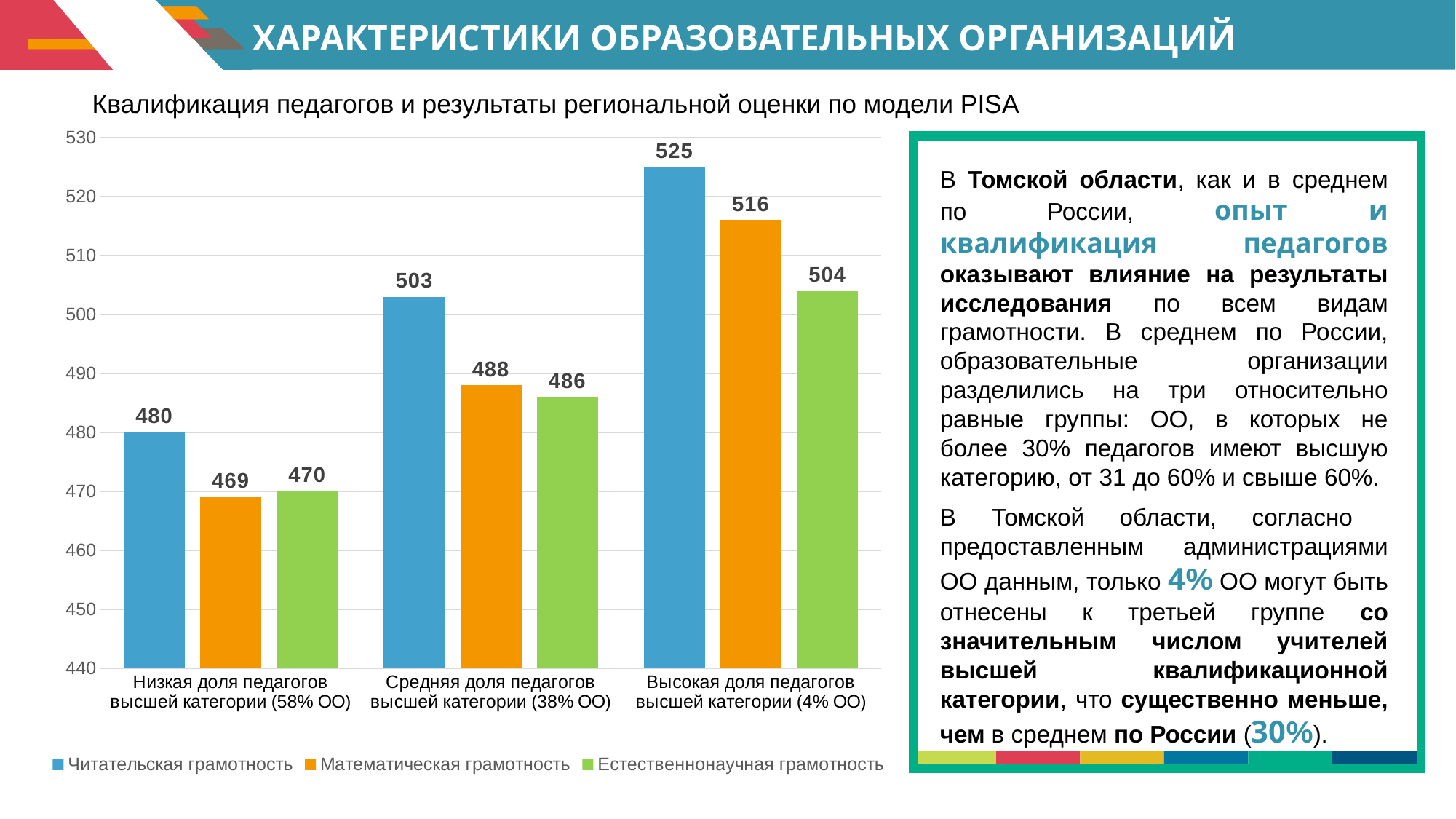
Is the value for Естественнонаучная грамотность in the Высокая доля (4% ОО) category greater or less than 500? greater Which is larger in the Средняя доля педагогов высшей категории (38% ОО) category: Математическая грамотность or Естественнонаучная грамотность? Математическая грамотность What is the value for Математическая грамотность in the category Высокая доля педагогов высшей категории (4% ОО)? 516 How many categories are shown on the x axis? 3 Which category has the highest value for Читательская грамотность? Высокая доля педагогов высшей категории (4% ОО) How many series does the legend list? 3 What is the difference between Читательская грамотность in the Высокая доля (4% ОО) category and in the Низкая доля (58% ОО) category? 45 Do the values for Читательская грамотность rise or fall from left to right across the categories? rise What kind of chart is shown on the slide? bar chart Which category has the lowest value for Математическая грамотность? Низкая доля педагогов высшей категории (58% ОО) What is the value for Естественнонаучная грамотность in the category Средняя доля педагогов высшей категории (38% ОО)? 486 What is the value for Читательская грамотность in the category Низкая доля педагогов высшей категории (58% ОО)? 480